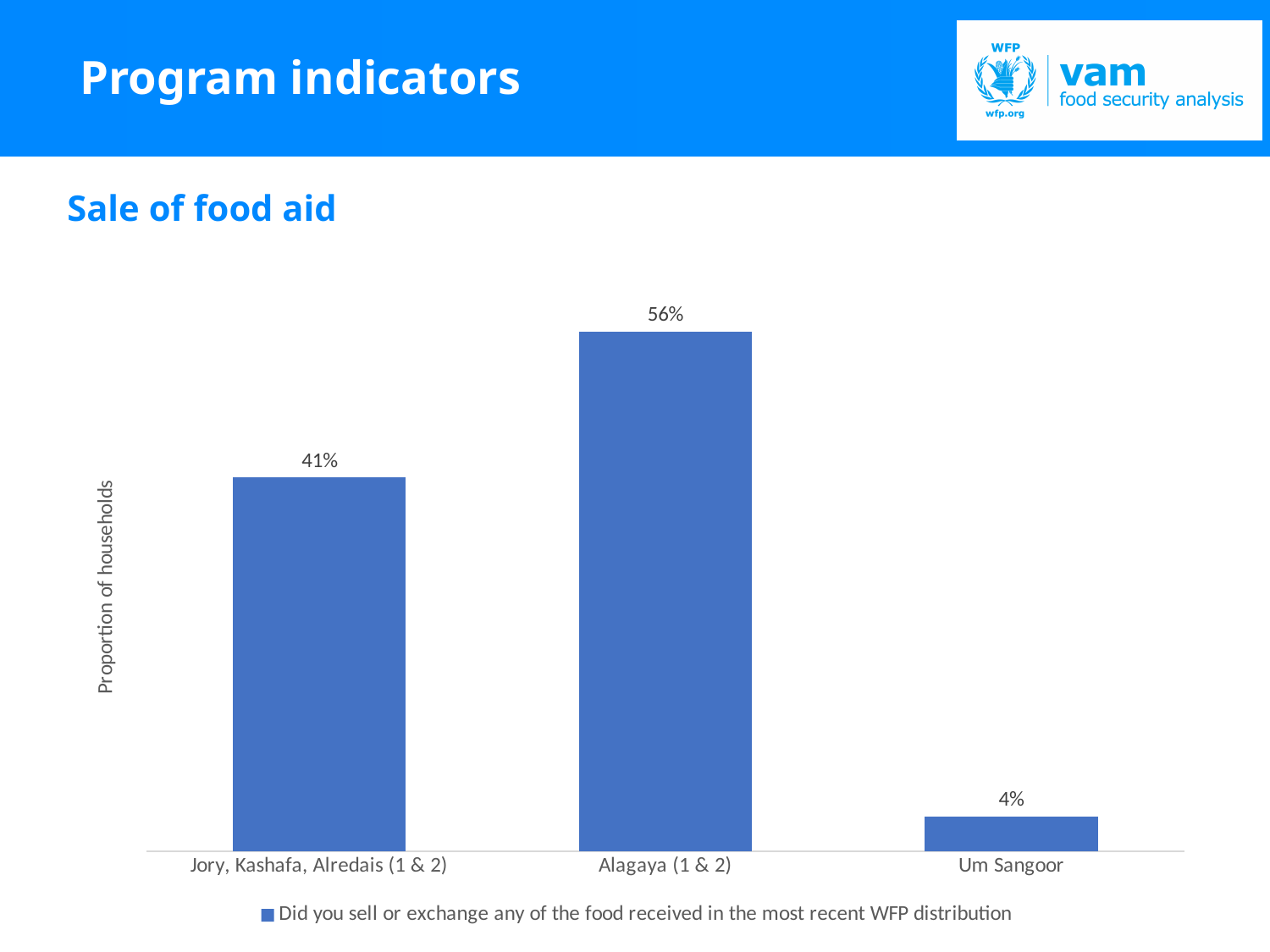
What is the difference between the values for Jory, Kashafa, Alredais (1 & 2) and Um Sangoor? 37% How many categories are shown on the x axis? 3 Which category has the highest value? Alagaya (1 & 2) How many series does the legend list? 1 Which category has the lowest value? Um Sangoor What is the value for Jory, Kashafa, Alredais (1 & 2)? 41% What is the difference between the values for Alagaya (1 & 2) and Jory, Kashafa, Alredais (1 & 2)? 15% What is the label on the vertical axis of the chart? Proportion of households What is the value for Alagaya (1 & 2)? 56% What kind of chart is shown on the slide? Bar chart What is the value for Um Sangoor? 4% Which is larger, the value for Alagaya (1 & 2) or the value for Um Sangoor? Alagaya (1 & 2)